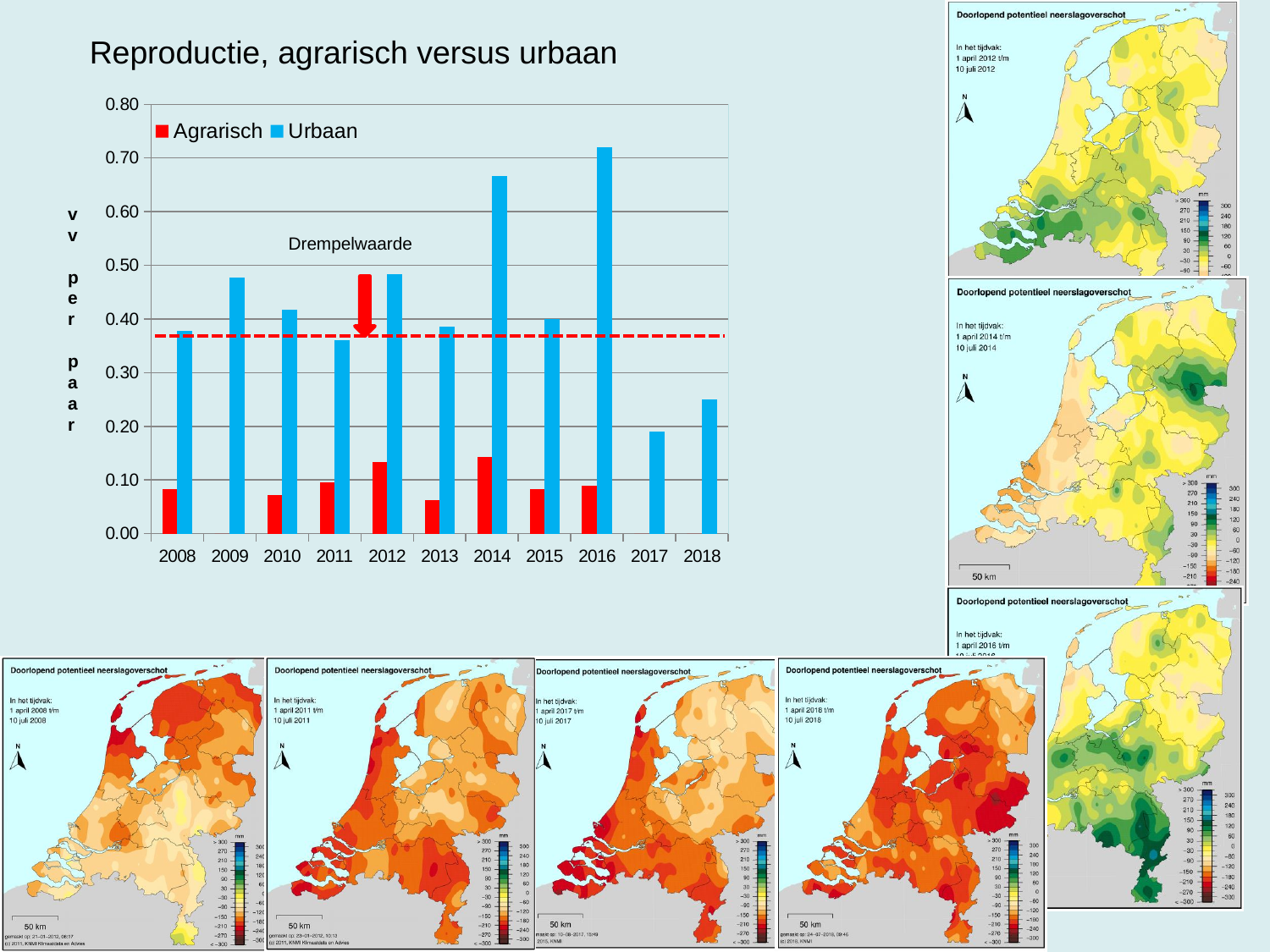
Is the Urbaan value for 2014 greater or less than 0.60? greater How many series does the legend of the bar chart list? 2 What colour are the Agrarisch bars in the chart? red In which year is the Urbaan value highest? 2016 What kind of chart is shown on the slide? bar chart In which year is the Urbaan value lowest? 2017 What label is given to the dashed horizontal line in the chart? Drempelwaarde How many years are shown on the x axis of the bar chart? 11 Is the Agrarisch value for 2012 greater or less than 0.10? greater Which is larger, the Urbaan value for 2009 or the Urbaan value for 2018? 2009 Do the Urbaan values rise or fall from 2016 to 2017? fall